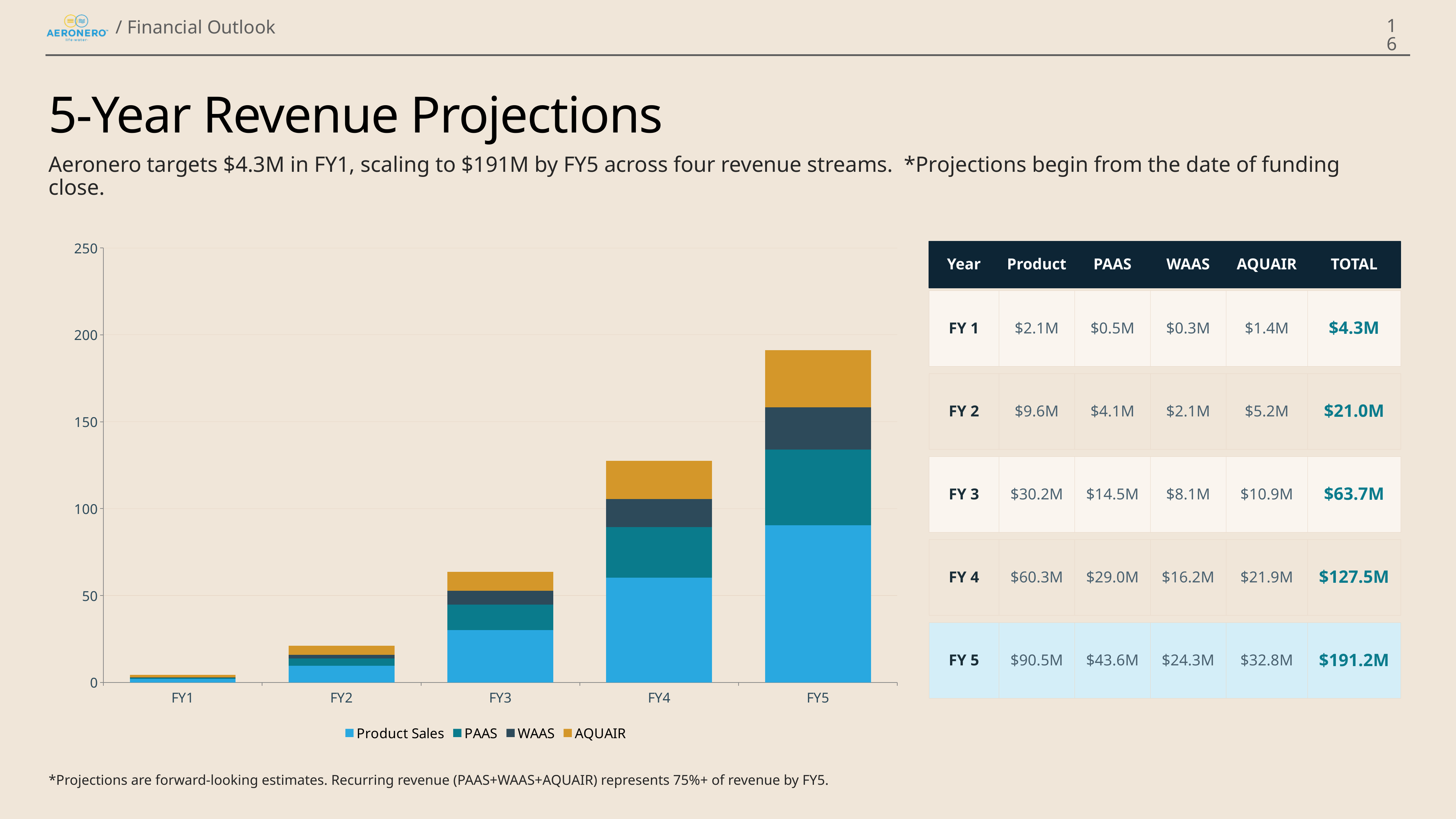
Which series is shown in the gold/orange colour at the top of each stacked bar? AQUAIR Is the total stacked bar for FY3 greater or less than 100? less How many fiscal years are plotted along the x axis of the chart? 5 What kind of chart is shown on the slide? Stacked bar chart Which stacked bar is taller, FY3 or FY4? FY4 According to the table on the slide, what is the TOTAL revenue for FY 5? $191.2M Is the total stacked bar for FY5 greater or less than 150? greater Is the total stacked bar for FY4 greater or less than 100? greater How many series does the chart legend list? 4 Which fiscal year has the shortest stacked bar in the chart? FY1 Which fiscal year has the tallest stacked bar in the chart? FY5 Do the total bar heights rise or fall from FY1 to FY5? Rise